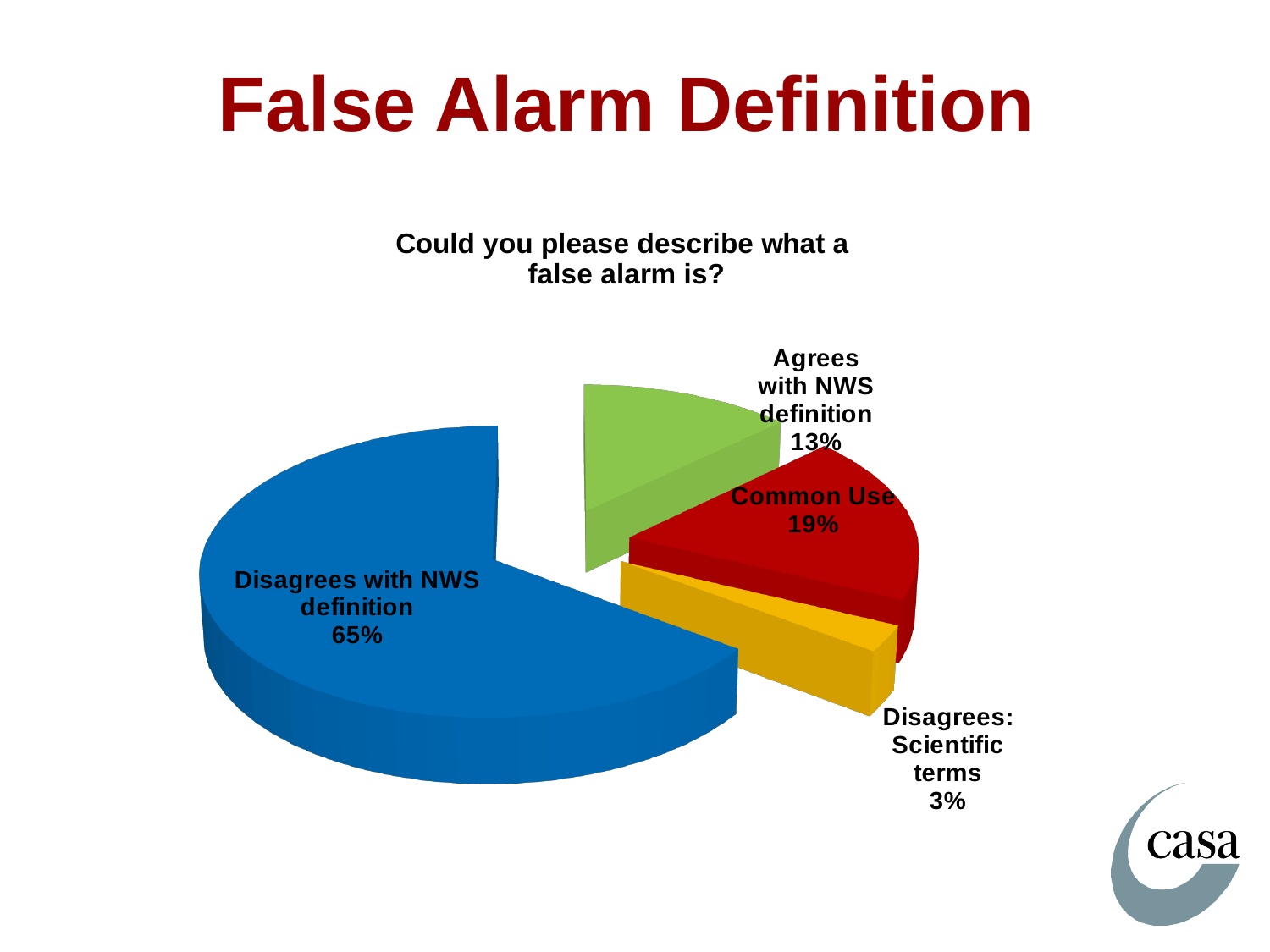
What share of the pie is labelled "Agrees with NWS definition"? 13% Which is larger, the "Common Use" slice or the "Agrees with NWS definition" slice? Common Use What share of the pie is labelled "Disagrees: Scientific terms"? 3% Which slice of the pie is the largest? Disagrees with NWS definition What is the difference between the "Disagrees with NWS definition" share and the "Common Use" share? 46% What kind of chart is shown on the slide? pie chart What share of the pie is labelled "Common Use"? 19% What is the chart's title? Could you please describe what a false alarm is? What share of the pie is labelled "Disagrees with NWS definition"? 65% What colour is the "Disagrees with NWS definition" slice? blue Which slice of the pie is the smallest? Disagrees: Scientific terms How many slices does the pie chart have? 4